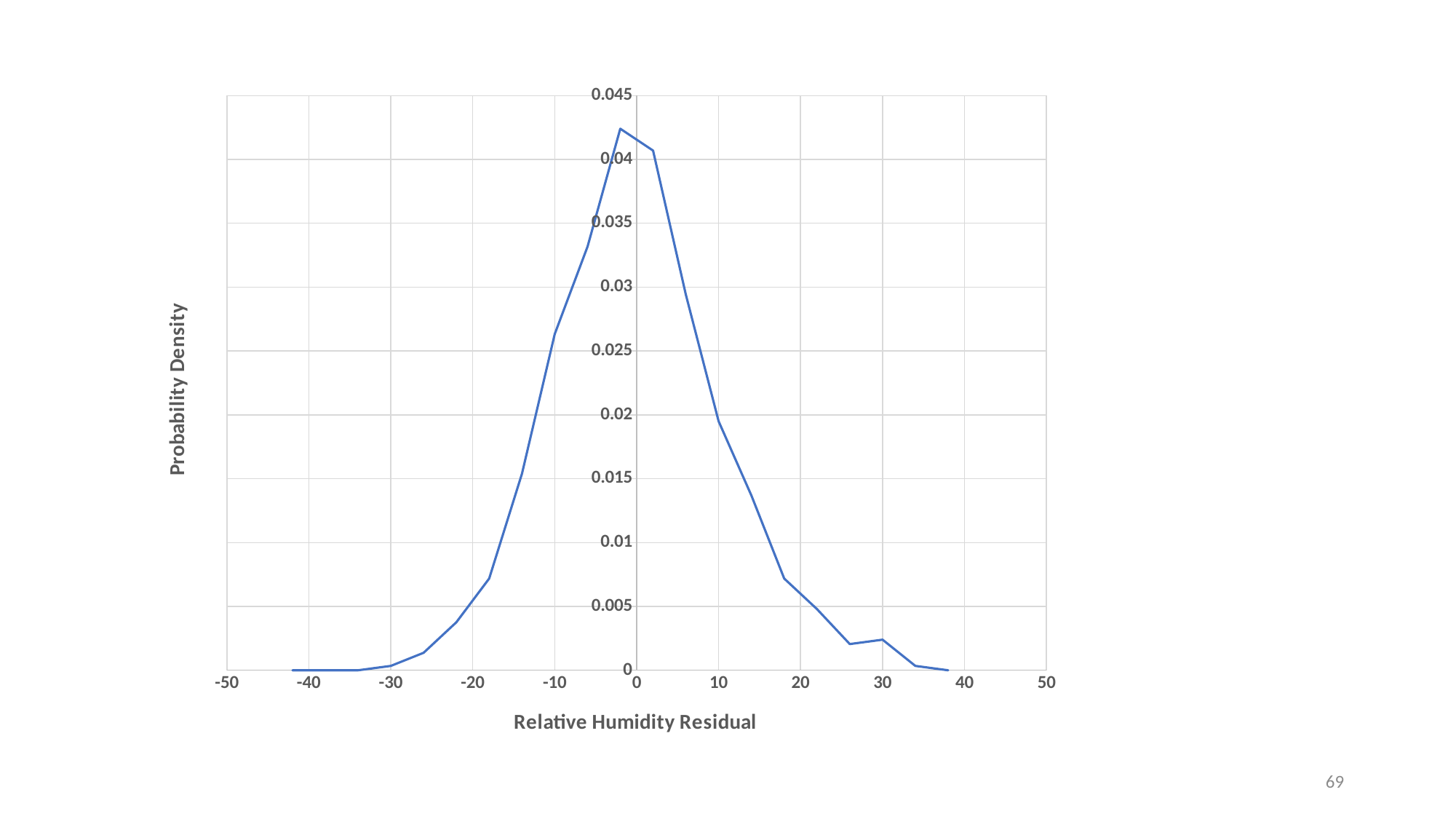
Is the value at a Relative Humidity Residual of 30 greater or less than 0.005? less Does the probability density rise or fall as the residual increases from 0 to 40? fall Which is larger, the probability density at a residual of -10 or at a residual of 10? -10 Is the value at a Relative Humidity Residual of -26 greater or less than 0.005? less What is the label of the y axis? Probability Density Does the probability density rise or fall as the residual increases from -40 to 0? rise What is the label of the x axis? Relative Humidity Residual Is the value at a Relative Humidity Residual of 18 greater or less than 0.005? greater What type of chart is shown on the slide? line chart